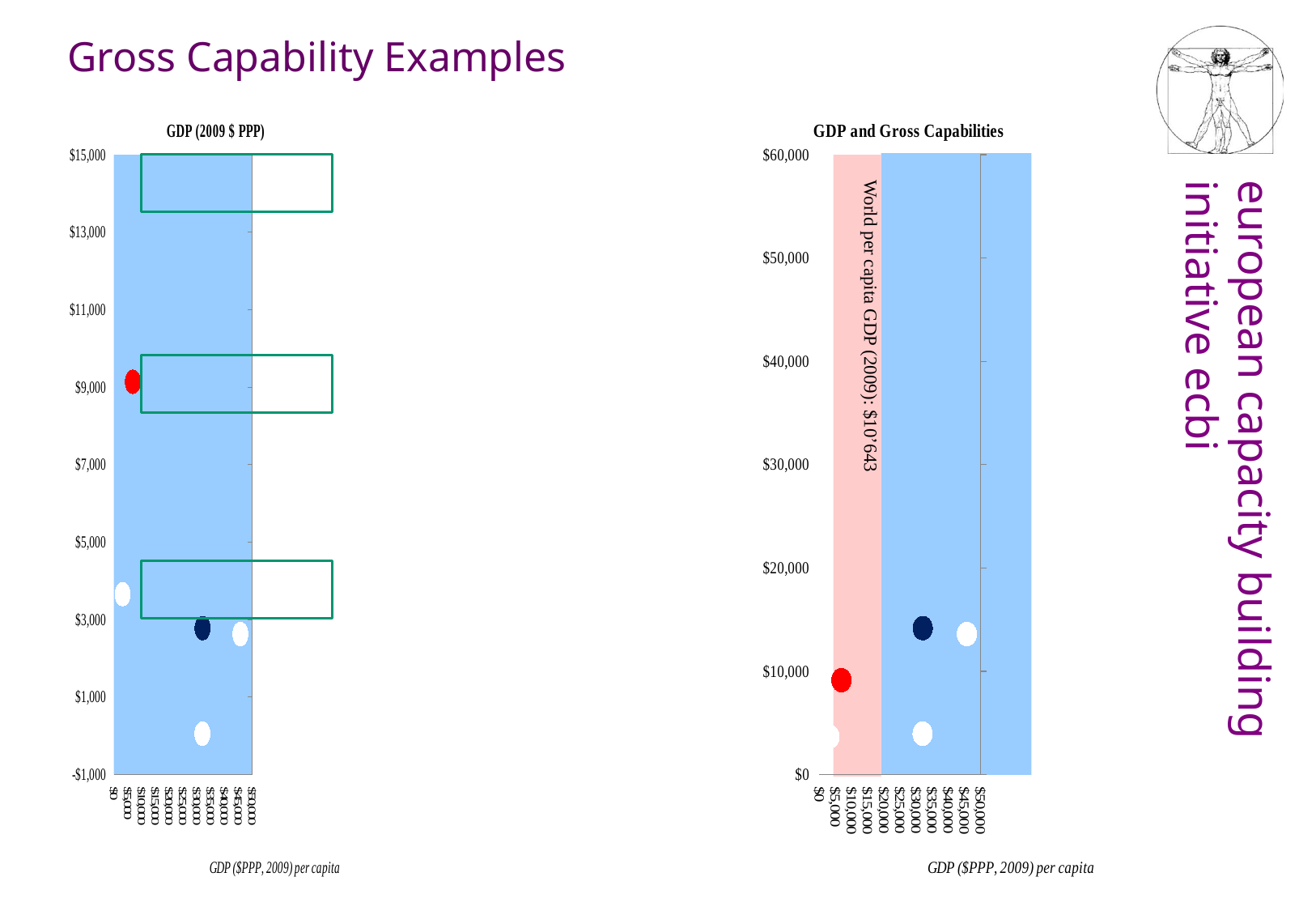
In the left chart "GDP (2009 $ PPP)", is the value of the red point greater or less than $7,000? greater How many data points are plotted in the left chart "GDP (2009 $ PPP)"? 5 In the right chart, what value does the annotation give for world per capita GDP (2009)? $10'643 In the right chart "GDP and Gross Capabilities", is the value of the dark blue point greater or less than $10,000? greater In the right chart "GDP and Gross Capabilities", is the value of the red point greater or less than $20,000? less What kind of chart is the right chart titled "GDP and Gross Capabilities"? scatter chart In the left chart "GDP (2009 $ PPP)", which is higher, the red point or the dark blue point? the red point In the right chart "GDP and Gross Capabilities", which is higher, the dark blue point or the red point? the dark blue point What is the title of the right chart? GDP and Gross Capabilities What kind of chart is the left chart titled "GDP (2009 $ PPP)"? scatter chart